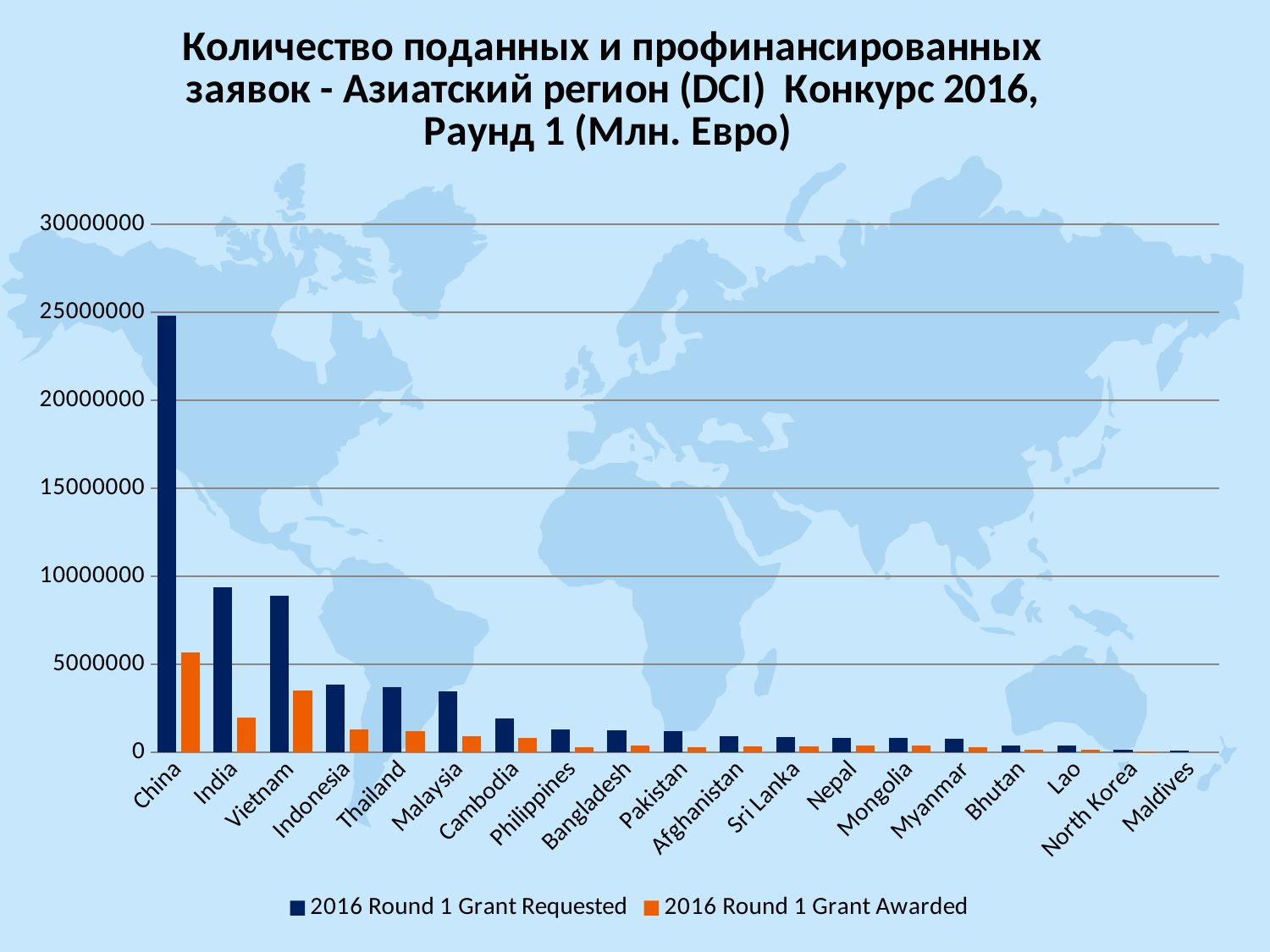
Which country has the highest 2016 Round 1 Grant Requested value? China Do the 2016 Round 1 Grant Requested values generally rise or fall from left to right along the x axis? fall What kind of chart is shown on the slide? bar chart Is the 2016 Round 1 Grant Awarded value for Vietnam greater or less than 5000000? less Is the 2016 Round 1 Grant Requested value for India greater or less than 10000000? less What colour are the bars for the 2016 Round 1 Grant Awarded series? orange Is the 2016 Round 1 Grant Requested value for China greater or less than 20000000? greater Which country has the highest 2016 Round 1 Grant Awarded value? China Which is larger, the 2016 Round 1 Grant Awarded value for Vietnam or for India? Vietnam How many countries are shown on the x axis? 19 How many series does the legend list? 2